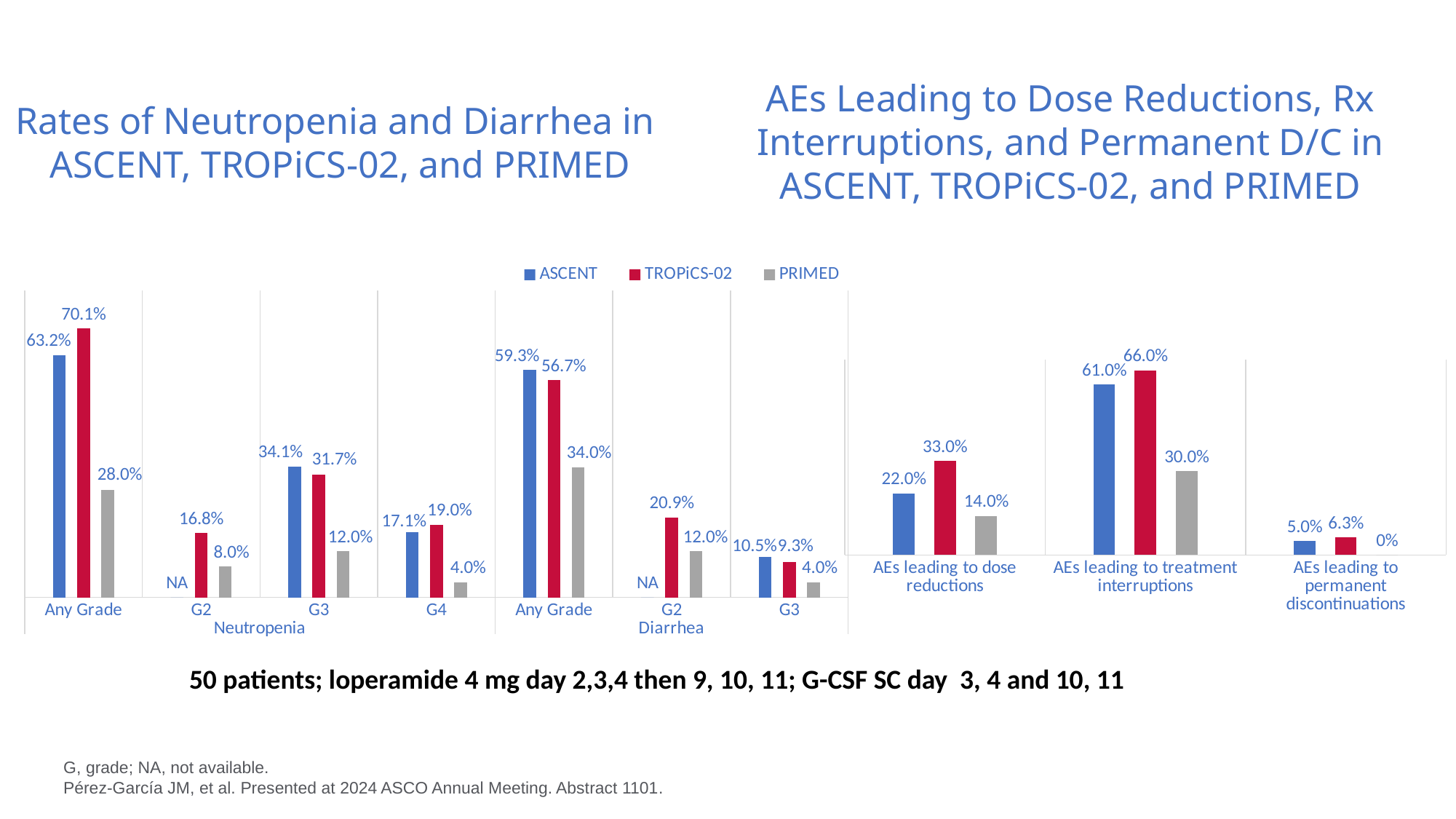
In the chart titled 'Rates of Neutropenia and Diarrhea in ASCENT, TROPiCS-02, and PRIMED', what is the G3 neutropenia rate for PRIMED? 12.0% In the chart titled 'Rates of Neutropenia and Diarrhea in ASCENT, TROPiCS-02, and PRIMED', what value is shown for ASCENT at G2 neutropenia? NA In the chart titled 'Rates of Neutropenia and Diarrhea in ASCENT, TROPiCS-02, and PRIMED', what is the Any Grade diarrhea rate for ASCENT? 59.3% How many series does the legend list for the charts on this slide? 3 In the chart titled 'AEs Leading to Dose Reductions, Rx Interruptions, and Permanent D/C in ASCENT, TROPiCS-02, and PRIMED', what is the rate of AEs leading to permanent discontinuations for PRIMED? 0% In the chart titled 'Rates of Neutropenia and Diarrhea in ASCENT, TROPiCS-02, and PRIMED', which study has the lowest G3 diarrhea rate? PRIMED In the chart titled 'Rates of Neutropenia and Diarrhea in ASCENT, TROPiCS-02, and PRIMED', what is the difference between the Any Grade diarrhea rates for ASCENT and PRIMED? 25.3% In the chart titled 'AEs Leading to Dose Reductions, Rx Interruptions, and Permanent D/C in ASCENT, TROPiCS-02, and PRIMED', what is the rate of AEs leading to treatment interruptions for TROPiCS-02? 66.0% In the chart titled 'Rates of Neutropenia and Diarrhea in ASCENT, TROPiCS-02, and PRIMED', what is the Any Grade neutropenia rate for TROPiCS-02? 70.1% In the chart titled 'AEs Leading to Dose Reductions, Rx Interruptions, and Permanent D/C in ASCENT, TROPiCS-02, and PRIMED', what is the difference between the ASCENT and PRIMED rates of AEs leading to treatment interruptions? 31.0% In the chart titled 'Rates of Neutropenia and Diarrhea in ASCENT, TROPiCS-02, and PRIMED', which study has the highest Any Grade neutropenia rate? TROPiCS-02 In the chart titled 'AEs Leading to Dose Reductions, Rx Interruptions, and Permanent D/C in ASCENT, TROPiCS-02, and PRIMED', which study has the highest rate of AEs leading to dose reductions? TROPiCS-02